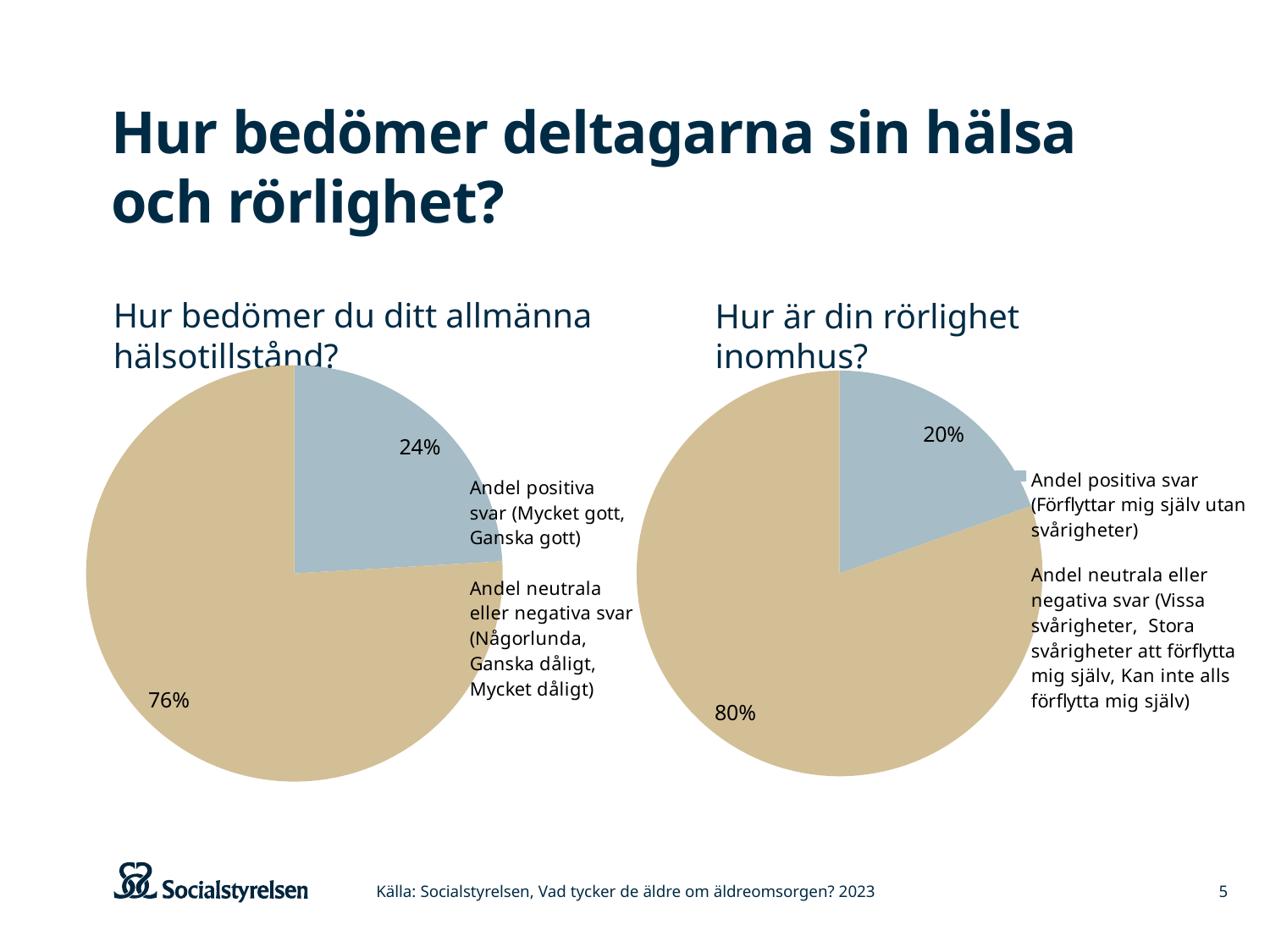
In the right pie chart (Hur är din rörlighet inomhus?), what share is labelled for the neutral or negative answers? 80% Which chart shows a larger share of positive answers: the left chart (allmänna hälsotillstånd) or the right chart (rörlighet inomhus)? The left chart (allmänna hälsotillstånd) In the left pie chart (Hur bedömer du ditt allmänna hälsotillstånd?), what share is labelled for the neutral or negative answers? 76% How many slices does the right pie chart (Hur är din rörlighet inomhus?) have? 2 In the right pie chart (Hur är din rörlighet inomhus?), what share is labelled for the positive answers (Andel positiva svar)? 20% In the left pie chart (Hur bedömer du ditt allmänna hälsotillstånd?), what share is labelled for the positive answers (Andel positiva svar)? 24% In the right pie chart (Hur är din rörlighet inomhus?), what is the difference in percentage points between the neutral/negative share and the positive share? 60 percentage points In the right pie chart (Hur är din rörlighet inomhus?), which category has the smallest slice? Andel positiva svar In the left pie chart (Hur bedömer du ditt allmänna hälsotillstånd?), what colour is the slice for the positive answers? Blue (light blue-grey) What type of chart is used on this slide for the two questions? Pie chart In the left pie chart (Hur bedömer du ditt allmänna hälsotillstånd?), which category has the largest slice? Andel neutrala eller negativa svar In the left pie chart (Hur bedömer du ditt allmänna hälsotillstånd?), what is the difference in percentage points between the neutral/negative share and the positive share? 52 percentage points